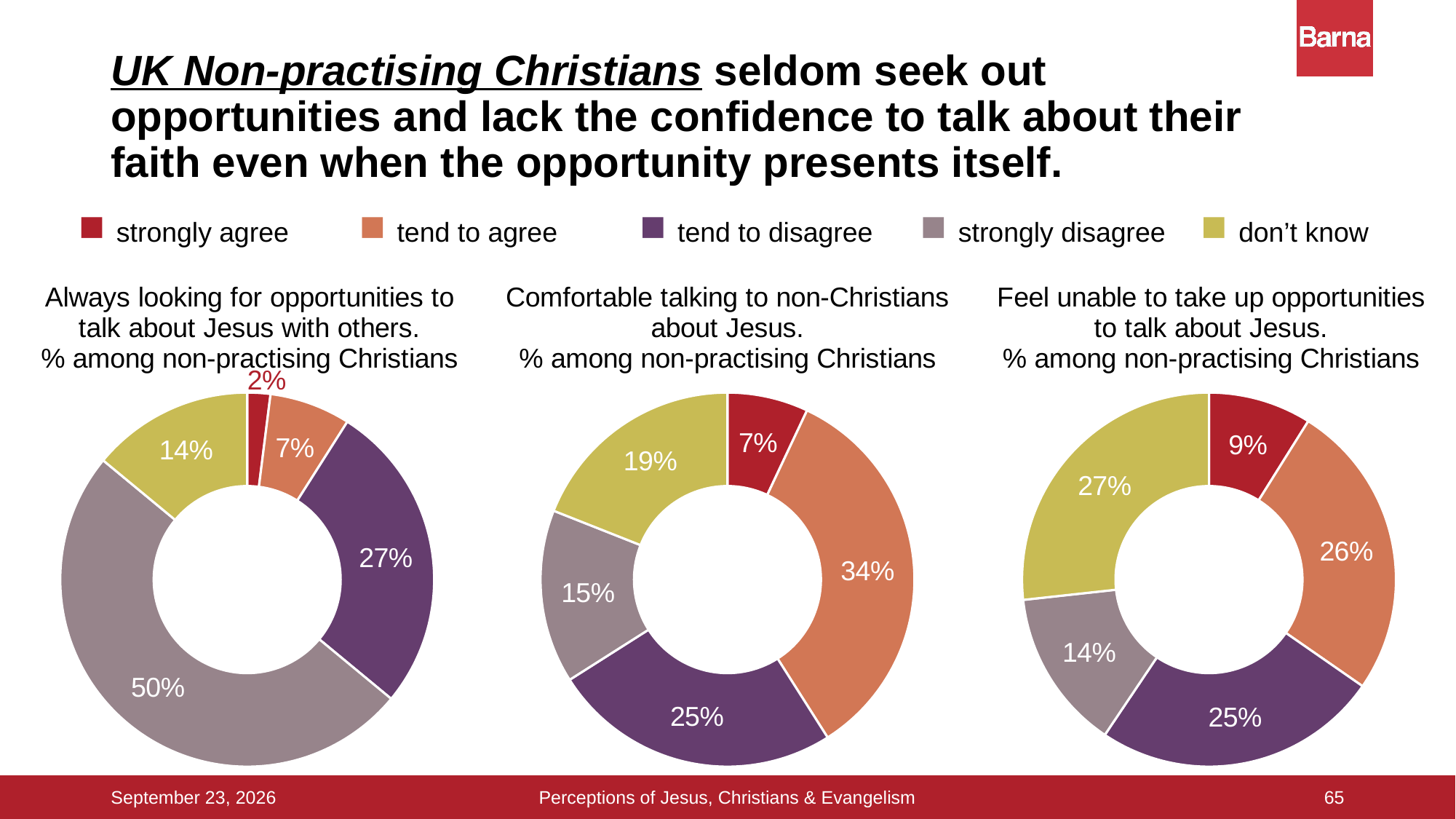
In the 'Always looking for opportunities to talk about Jesus with others' chart, what percentage strongly agree? 2% How many charts are shown on the slide? 3 In the 'Comfortable talking to non-Christians about Jesus' chart, which response has the largest share? tend to agree In the 'Feel unable to take up opportunities to talk about Jesus' chart, which is larger: don't know or strongly disagree? don't know What type of chart is used on this slide? Donut (pie) chart In the 'Comfortable talking to non-Christians about Jesus' chart, what is the difference between the tend to agree and tend to disagree shares? 9% How many response categories does the legend list? 5 In the 'Feel unable to take up opportunities to talk about Jesus' chart, which response has the smallest share? strongly agree In the 'Always looking for opportunities to talk about Jesus with others' chart, which response has the smallest share? strongly agree In the 'Comfortable talking to non-Christians about Jesus' chart, what percentage tend to agree? 34% In the 'Always looking for opportunities to talk about Jesus with others' chart, what percentage strongly disagree? 50% In the 'Feel unable to take up opportunities to talk about Jesus' chart, what percentage answered don't know? 27%